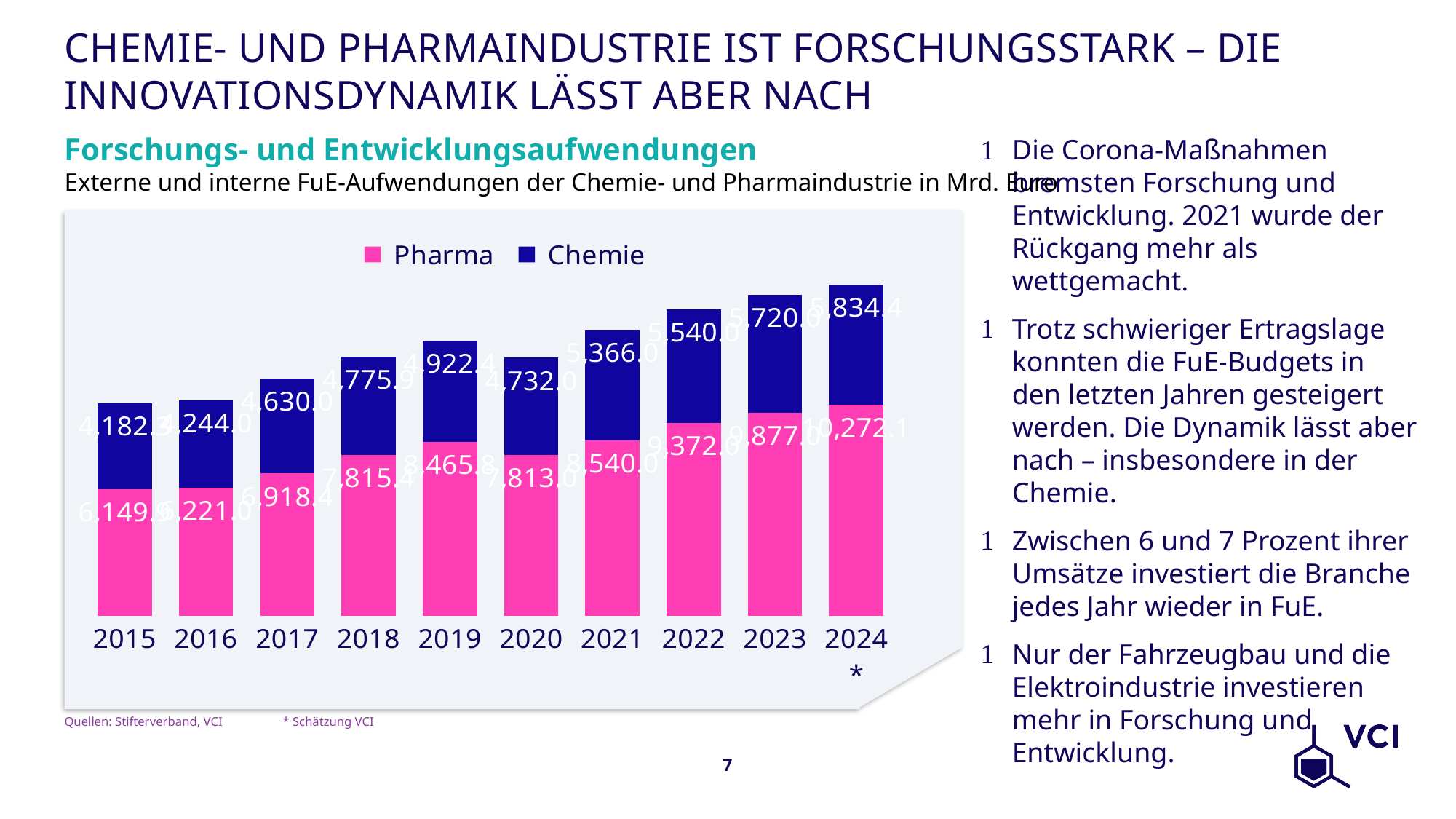
By how much did the Pharma value increase from 2020 to 2021? 727.0 What type of chart is shown on the slide? Stacked bar chart Which series is shown in pink in the chart? Pharma How many years are shown on the x axis of the chart? 10 How many series does the legend list? 2 What is the Chemie value for 2021? 5,366.0 What is the Pharma value for 2017? 6,918.4 What is the Pharma value for 2021? 8,540.0 What is the Chemie value for 2020? 4,732.0 What is the total of the stacked bar for 2021? 13,906.0 Which year has the lowest total bar? 2015 Which year has the highest total bar? 2024